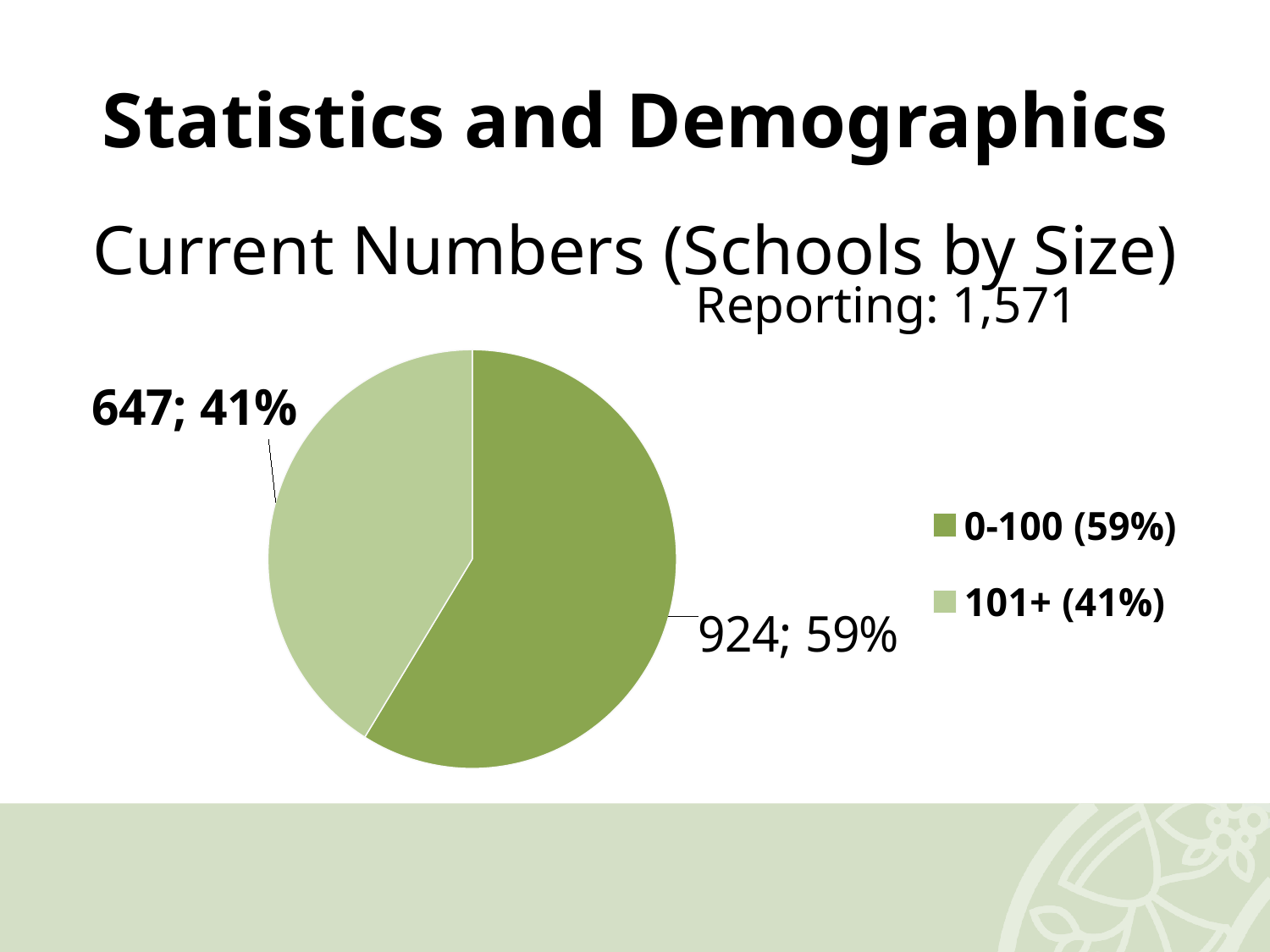
Which category has the smallest slice of the pie? 101+ What share of the pie does the 101+ category represent? 41% How many schools are in the 101+ size category? 647 What is the title of the chart? Current Numbers (Schools by Size) What kind of chart is shown on the slide? pie chart What is the total number of schools reporting, as shown on the slide? 1,571 Which category has the largest slice of the pie? 0-100 How many schools are in the 0-100 size category? 924 What share of the pie does the 0-100 category represent? 59% How many categories does the pie chart show? 2 What is the difference in the number of schools between the 0-100 and 101+ categories? 277 Which category has more schools, 0-100 or 101+? 0-100